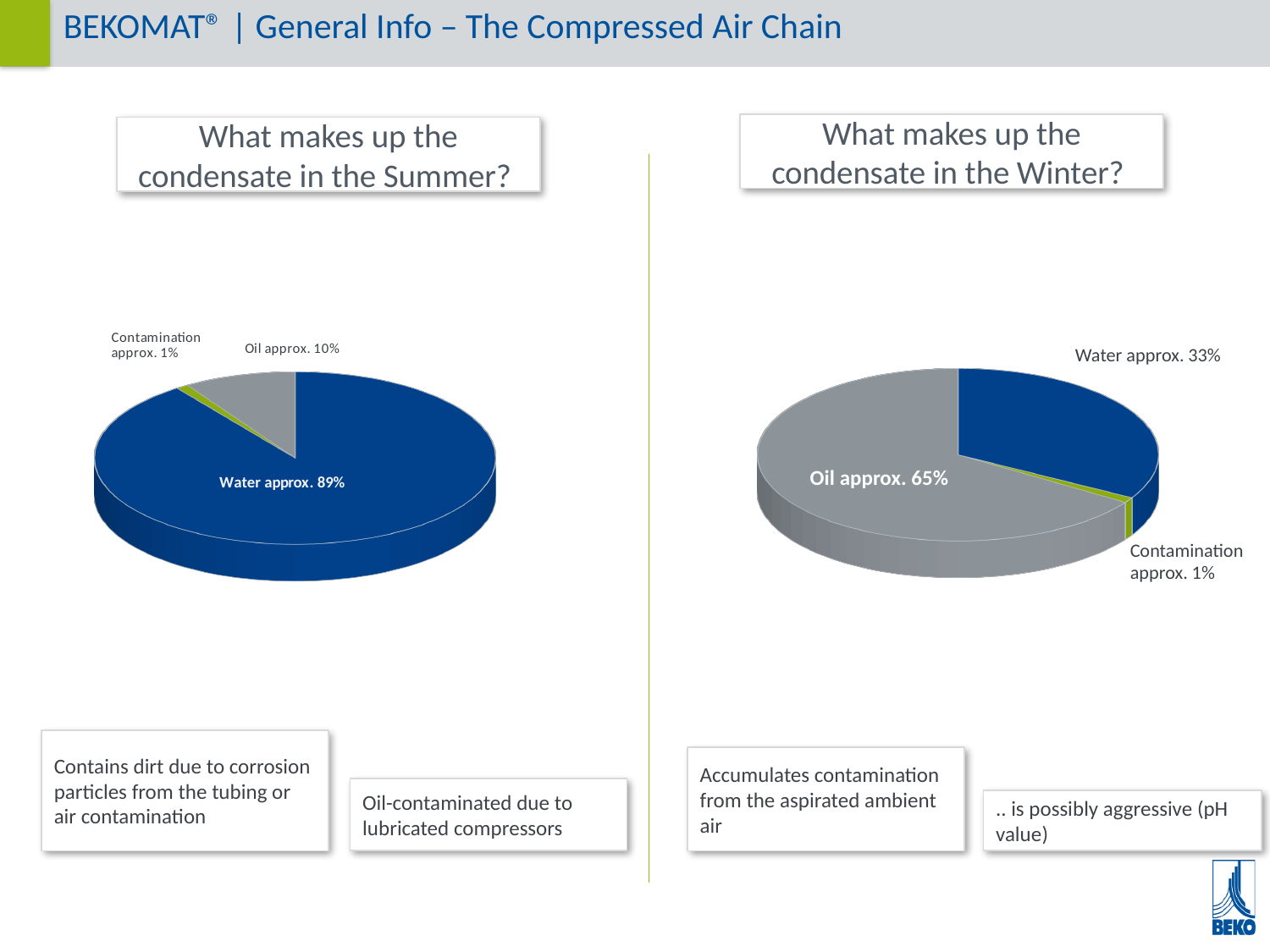
In the Summer pie chart, what share of the condensate is oil? approx. 10% In the Winter pie chart, what share of the condensate is contamination? approx. 1% In the Summer pie chart, what share of the condensate is water? approx. 89% In the Summer pie chart, which component makes up the largest share of the condensate? Water In the Summer pie chart, which component makes up the smallest share of the condensate? Contamination How many slices does the Summer pie chart have? 3 In the Winter pie chart, which component makes up the largest share of the condensate? Oil In the Winter pie chart, what share of the condensate is oil? approx. 65% In the Winter pie chart, is the share of oil larger or smaller than the share of water? larger What type of chart is used to show what makes up the condensate in the Winter? Pie chart In the Winter pie chart, what share of the condensate is water? approx. 33% What is the title above the left chart? What makes up the condensate in the Summer?